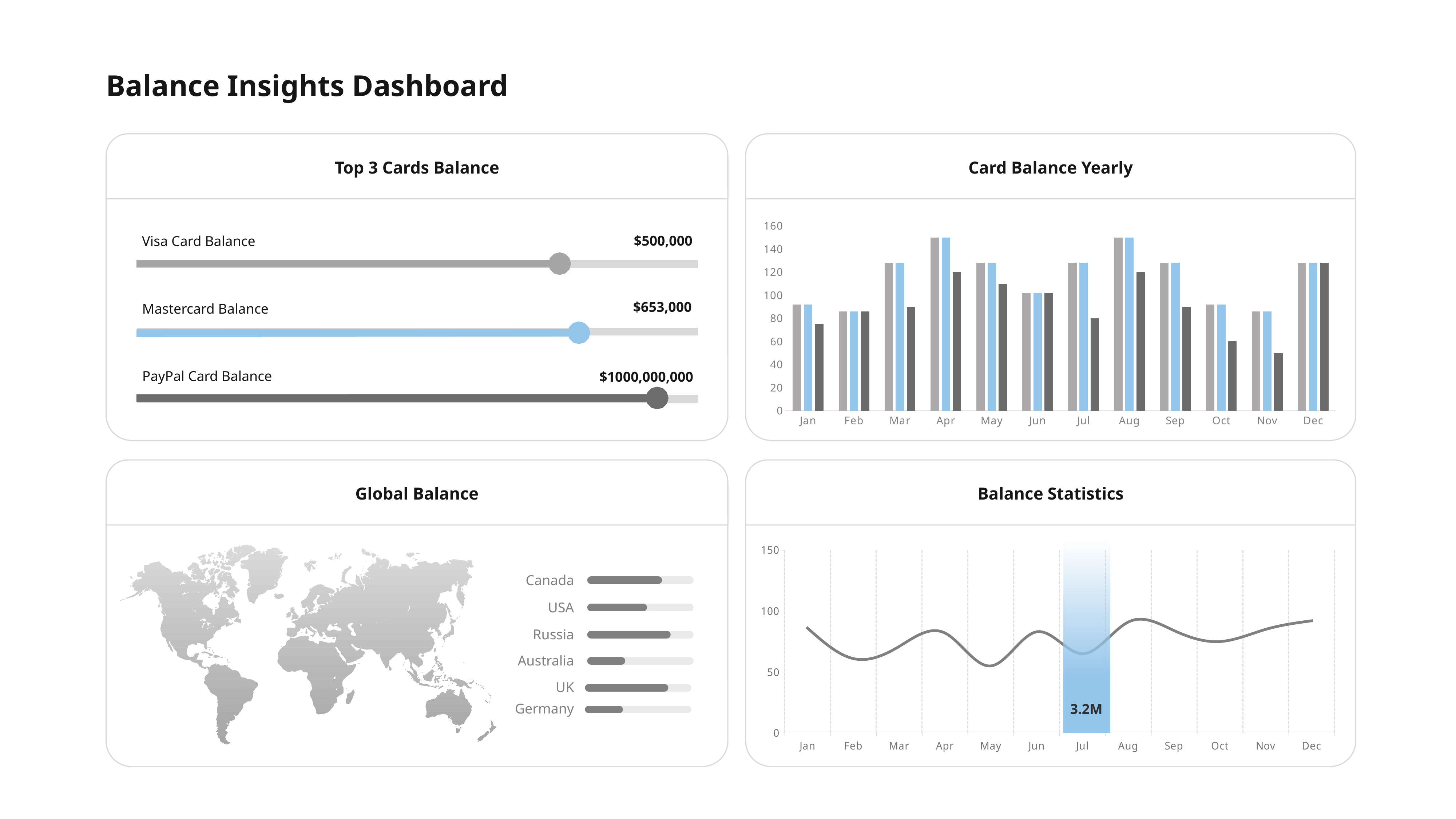
In the Card Balance Yearly chart, is the value of the first (light grey) bar for Apr greater or less than 140? greater In the Top 3 Cards Balance panel, which card has the lowest balance? Visa Card Balance In the Balance Statistics chart, does the line rise or fall from Jan to Feb? Fall In the Balance Statistics chart, what kind of chart is shown? Line chart In the Card Balance Yearly chart, how many bars are plotted for each month? 3 In the Card Balance Yearly chart, what kind of chart is shown? Bar chart In the Card Balance Yearly chart, is the value of the dark grey bar for Nov greater or less than 60? less In the Top 3 Cards Balance panel, what is the Mastercard Balance? $653,000 In the Card Balance Yearly chart, how many months are shown on the x axis? 12 In the Top 3 Cards Balance panel, what is the PayPal Card Balance? $1000,000,000 In the Balance Statistics chart, what value is labelled on the highlighted Jul column? 3.2M In the Top 3 Cards Balance panel, what is the difference between the Mastercard Balance and the Visa Card Balance? $153,000